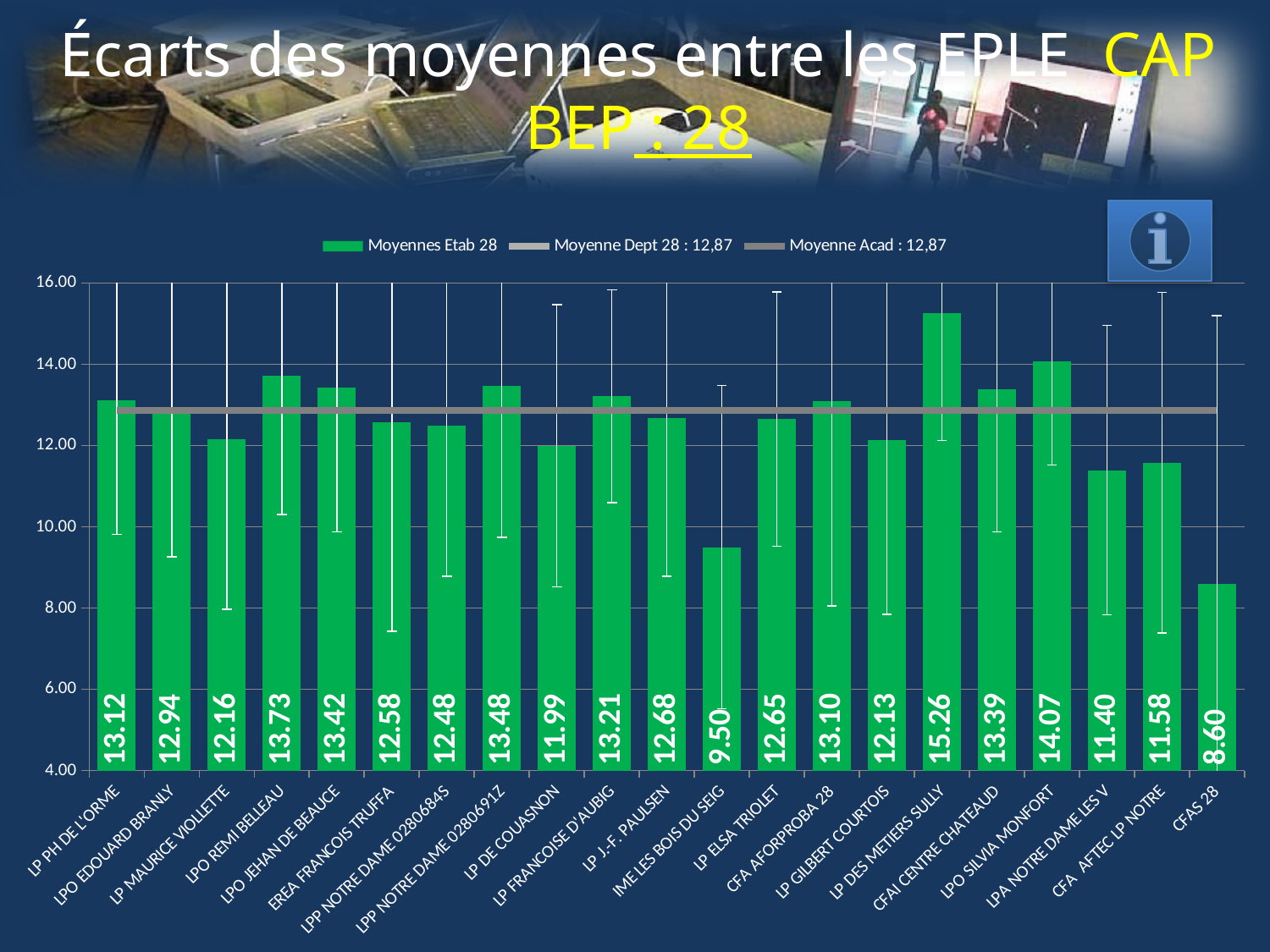
Which is larger, the value for LPO REMI BELLEAU or the value for LPO JEHAN DE BEAUCE? LPO REMI BELLEAU Which establishment has the lowest value? CFAS 28 How many series does the legend list? 3 Is the value for LP DE COUASNON greater or less than 12.00? less What value does the legend give for Moyenne Dept 28? 12,87 What is the value for IME LES BOIS DU SEIG? 9.50 What is the value for LPO SILVIA MONFORT? 14.07 How many establishments are shown on the x axis? 21 What is the difference between the values for LP DES METIERS SULLY and CFAS 28? 6.66 What kind of chart is shown on the slide? bar chart Which establishment has the highest value? LP DES METIERS SULLY What is the value for LP DES METIERS SULLY? 15.26